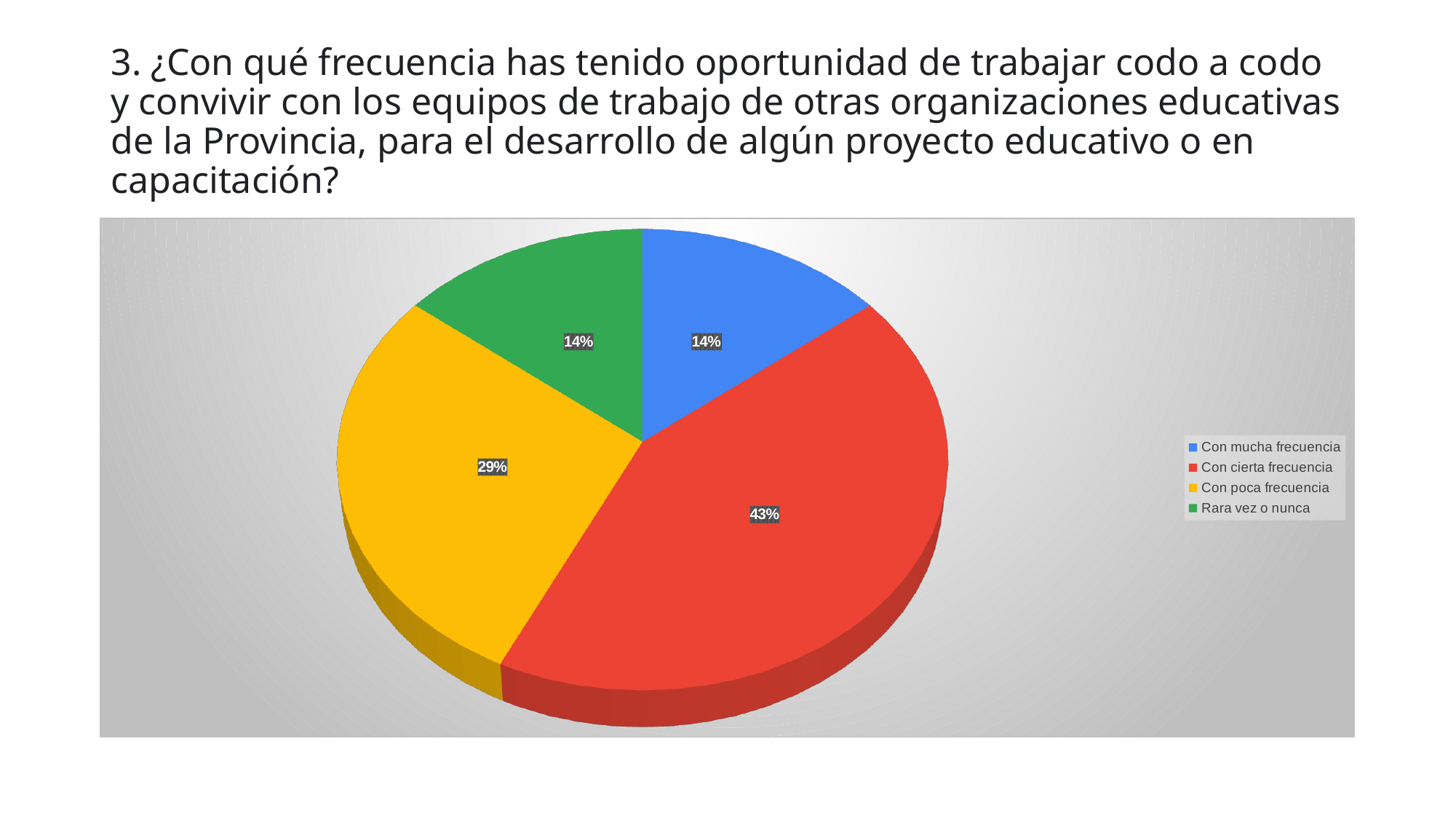
What colour is the slice for "Rara vez o nunca"? green How many entries does the legend list? 4 What kind of chart is shown on the slide? pie chart What is the difference between the shares of "Con cierta frecuencia" and "Con poca frecuencia"? 14% Which category has the largest slice of the pie? Con cierta frecuencia How many categories does the pie chart have? 4 Which is larger, the slice for "Con poca frecuencia" or the slice for "Rara vez o nunca"? Con poca frecuencia What share of the pie does "Con cierta frecuencia" represent? 43% What share of the pie does "Con poca frecuencia" represent? 29% What colour is the slice for "Con cierta frecuencia"? red What is the value shown for "Con mucha frecuencia"? 14% What is the value shown for "Rara vez o nunca"? 14%